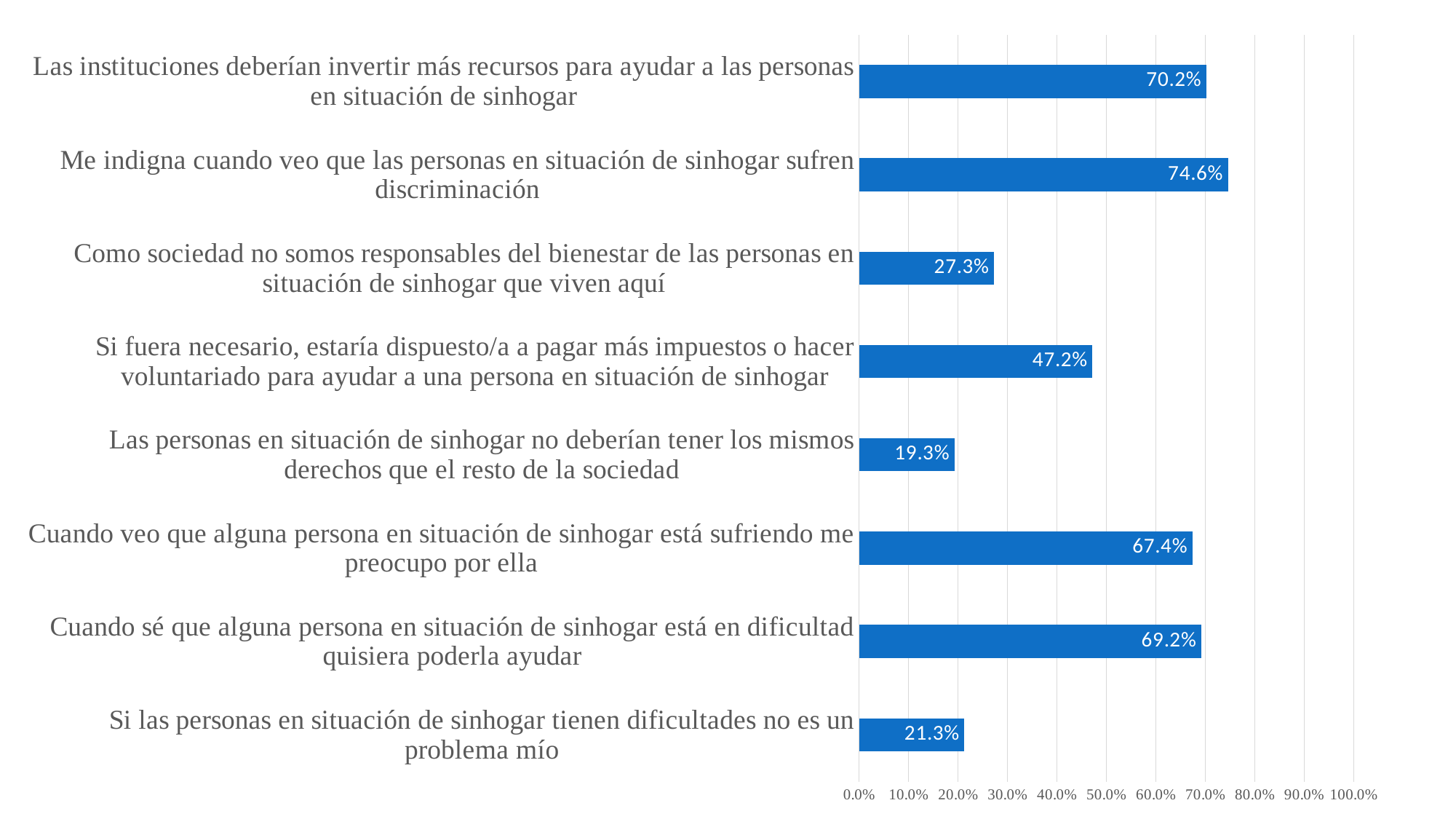
What is the value for "Si las personas en situación de sinhogar tienen dificultades no es un problema mío"? 21.3% What is the maximum value shown on the horizontal axis? 100.0% What kind of chart is shown on the slide? bar chart Which statement has the lowest value? Las personas en situación de sinhogar no deberían tener los mismos derechos que el resto de la sociedad How many statements (bars) are shown in the chart? 8 Which is larger: the value for "Cuando veo que alguna persona en situación de sinhogar está sufriendo me preocupo por ella" or for "Cuando sé que alguna persona en situación de sinhogar está en dificultad quisiera poderla ayudar"? Cuando sé que alguna persona en situación de sinhogar está en dificultad quisiera poderla ayudar What is the difference between the values for "Me indigna cuando veo que las personas en situación de sinhogar sufren discriminación" and "Como sociedad no somos responsables del bienestar de las personas en situación de sinhogar que viven aquí"? 47.3% What is the value for "Si fuera necesario, estaría dispuesto/a a pagar más impuestos o hacer voluntariado para ayudar a una persona en situación de sinhogar"? 47.2% What is the difference between the values for "Las instituciones deberían invertir más recursos para ayudar a las personas en situación de sinhogar" and "Cuando sé que alguna persona en situación de sinhogar está en dificultad quisiera poderla ayudar"? 1.0% Is the value for "Como sociedad no somos responsables del bienestar de las personas en situación de sinhogar que viven aquí" greater or less than 30.0%? less Which statement has the highest value? Me indigna cuando veo que las personas en situación de sinhogar sufren discriminación What is the value for "Las instituciones deberían invertir más recursos para ayudar a las personas en situación de sinhogar"? 70.2%